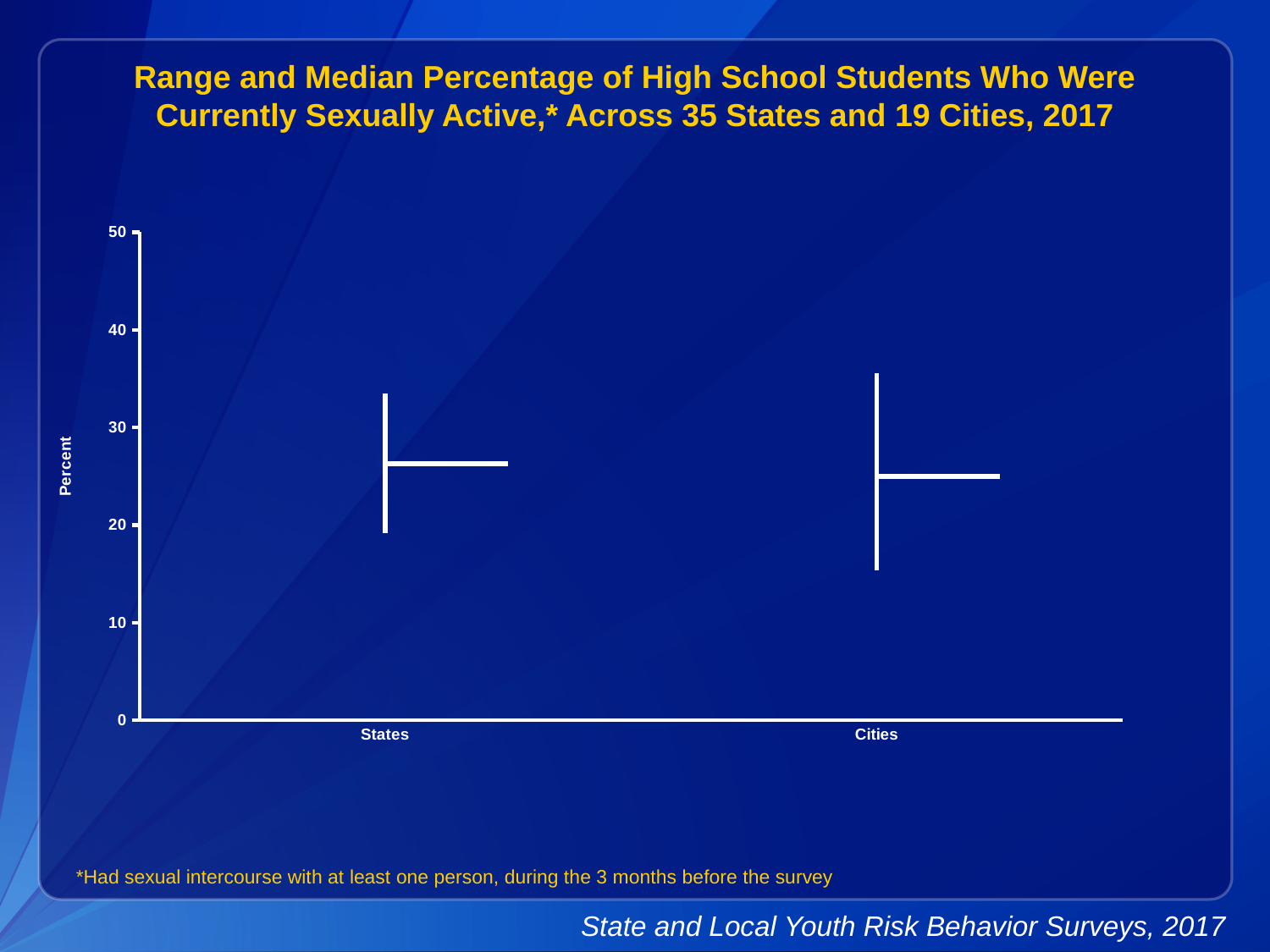
Is the median value for States greater or less than 30? less What are the two categories shown on the x axis? States and Cities Is the median value for Cities greater or less than 20? greater What is the label on the y axis of the chart? Percent Is the top of the range for Cities greater or less than 30? greater Which category has the wider range, States or Cities? Cities Which category has the lower bottom of its range, States or Cities? Cities How many categories are shown on the x axis of the chart? 2